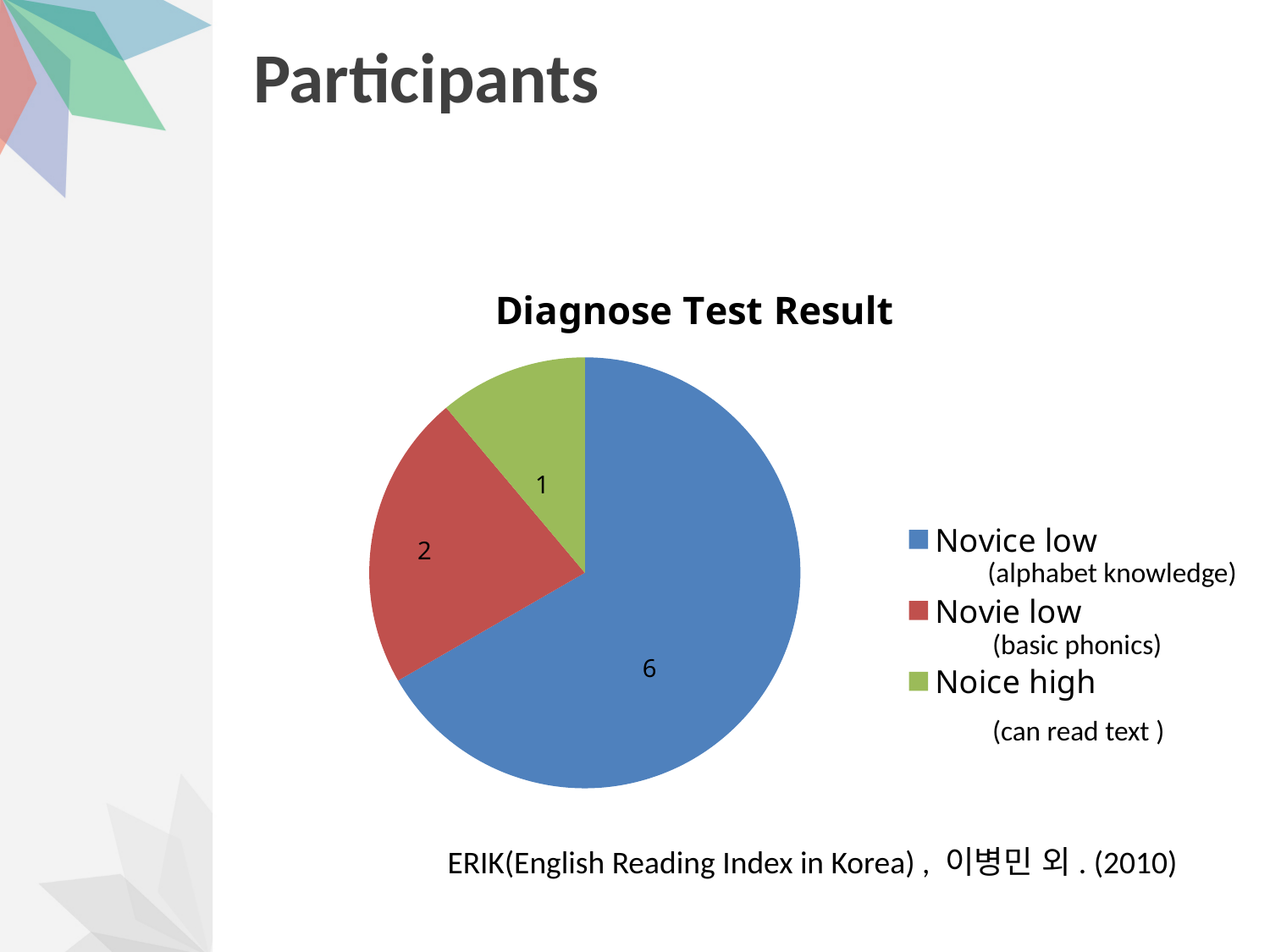
What is the value for the Novice low (alphabet knowledge) slice? 6 What is the difference between the Novice low (alphabet knowledge) value and the Novie low (basic phonics) value? 4 What is the value for the Noice high (can read text) slice? 1 What share of the pie does the Novice low (alphabet knowledge) slice represent? two-thirds (6 of 9) Which category has the smallest slice? Noice high (can read text) Which is larger, the Novie low (basic phonics) slice or the Noice high (can read text) slice? Novie low (basic phonics) Which category has the largest slice? Novice low (alphabet knowledge) What is the value for the Novie low (basic phonics) slice? 2 How many entries does the legend list? 3 What kind of chart is shown on the slide? pie chart How many slices does the pie chart have? 3 What is the title of the chart? Diagnose Test Result